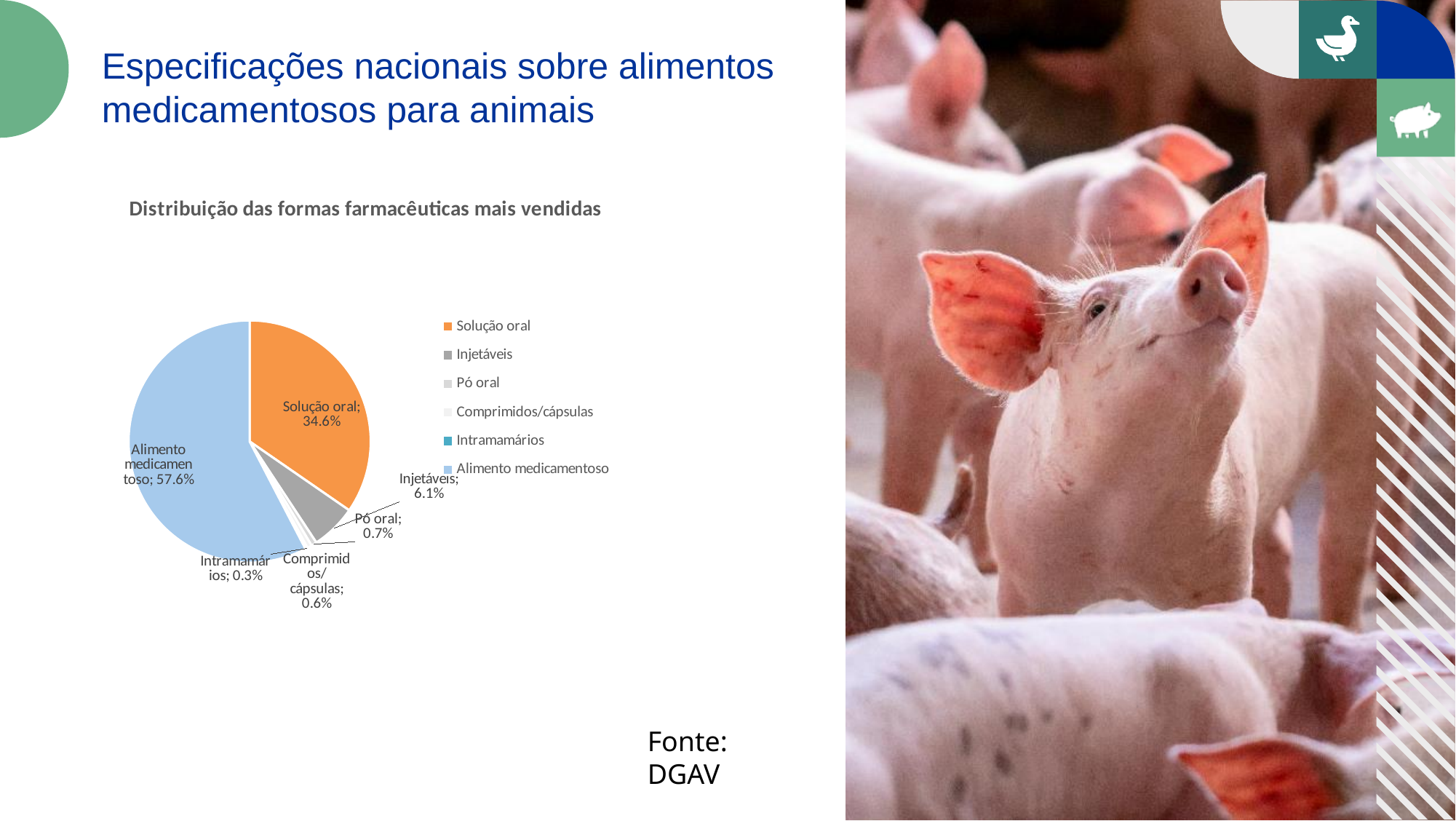
What is the title of the chart? Distribuição das formas farmacêuticas mais vendidas What kind of chart is shown on the slide? Pie chart Which category has the smallest slice of the pie? Intramamários How many categories does the pie chart show? 6 What is the difference between the shares of Alimento medicamentoso and Solução oral? 23.0% What is the value shown for Solução oral? 34.6% What share of the pie does Alimento medicamentoso have? 57.6% What is the value shown for Pó oral? 0.7% What is the value shown for Injetáveis? 6.1% Which category has the largest slice of the pie? Alimento medicamentoso What is the value shown for Intramamários? 0.3% Which is larger, the share for Injetáveis or the share for Pó oral? Injetáveis